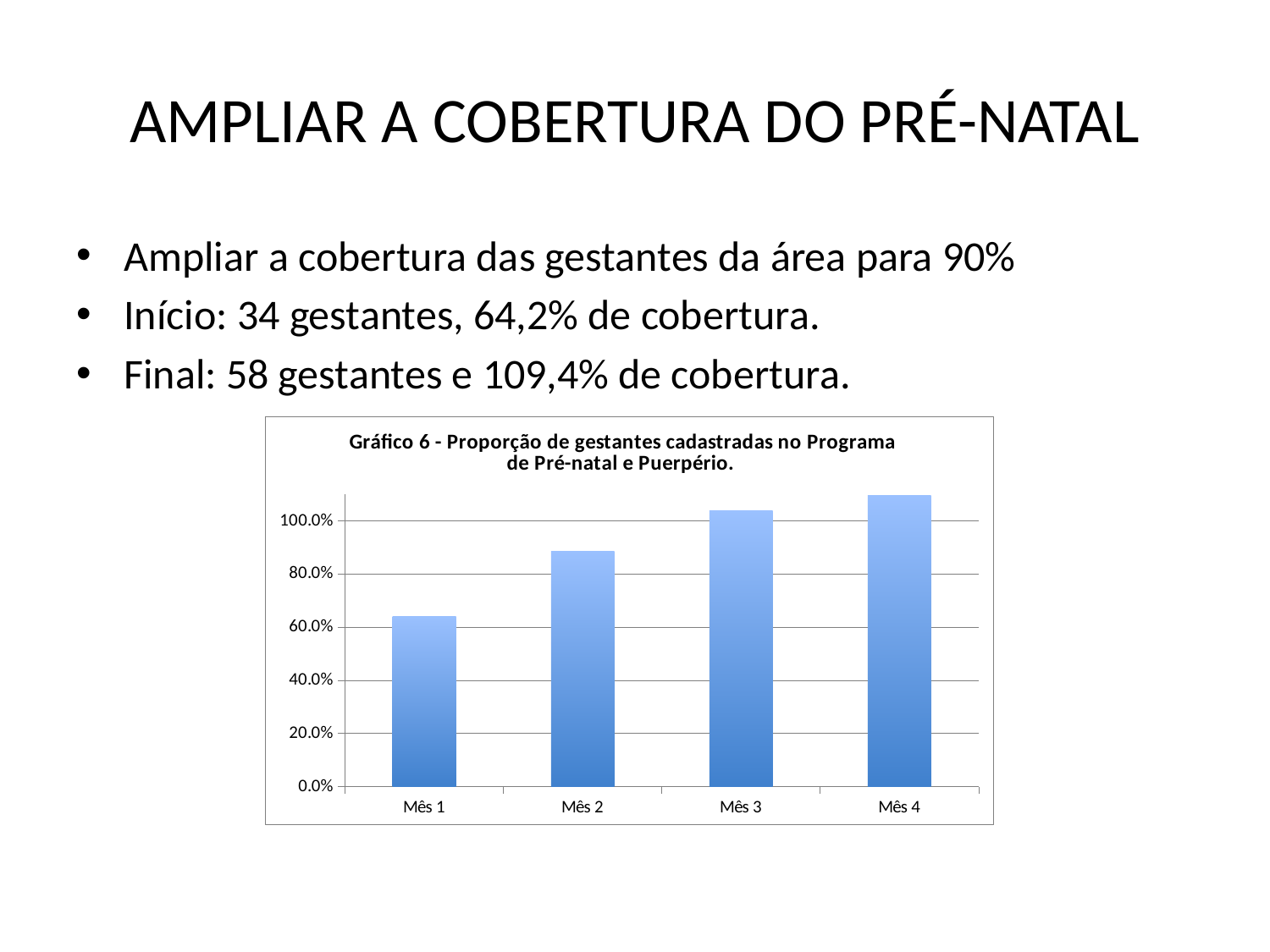
Which month has the lowest bar in the chart? Mês 1 What kind of chart is shown on the slide? bar chart Which month has the highest bar in the chart? Mês 4 What is the title of the chart? Gráfico 6 - Proporção de gestantes cadastradas no Programa de Pré-natal e Puerpério. Is the value for Mês 2 greater or less than 100.0%? less Is the value for Mês 2 greater or less than 80.0%? greater How many categories (months) are plotted in the chart? 4 Which is larger, the value for Mês 2 or the value for Mês 3? Mês 3 Is the value for Mês 3 greater or less than 100.0%? greater Do the values rise or fall from Mês 1 to Mês 4? rise